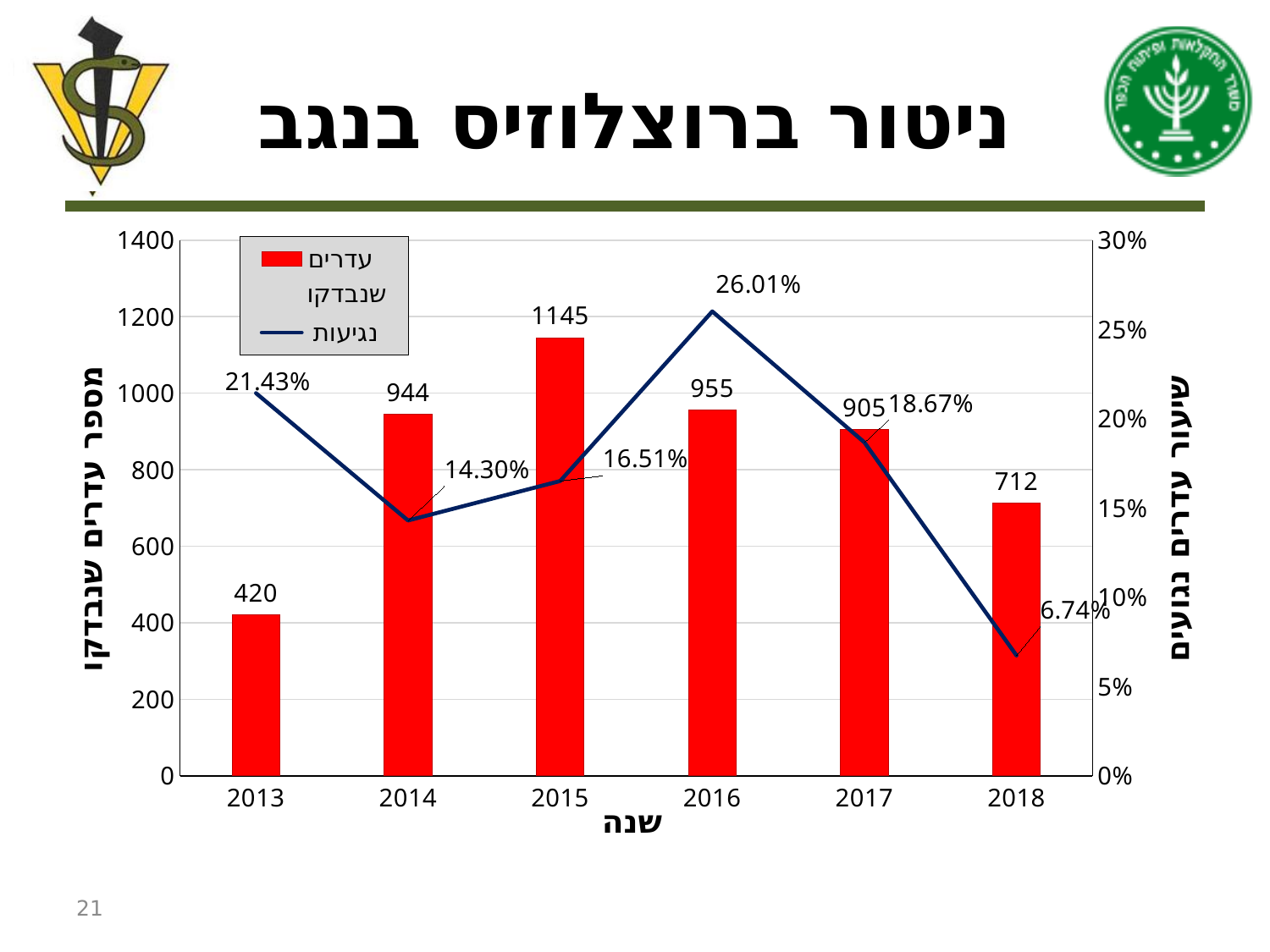
Which year has the highest number of herds tested? 2015 What is the infection rate (נגיעות) shown for 2016? 26.01% What is the infection rate (נגיעות) shown for 2018? 6.74% Which year had more herds tested, 2014 or 2017? 2014 What kind of chart is used for the herds tested (עדרים שנבדקו) series? Bar chart How many herds were tested (עדרים שנבדקו) in 2015? 1145 Does the infection rate (נגיעות) rise or fall from 2016 to 2018? Fall How many years are shown on the x axis? 6 Which year has the lowest number of herds tested? 2013 What is the difference between the number of herds tested in 2015 and in 2018? 433 How many series does the legend list? 2 Which year has the lowest infection rate (נגיעות)? 2018